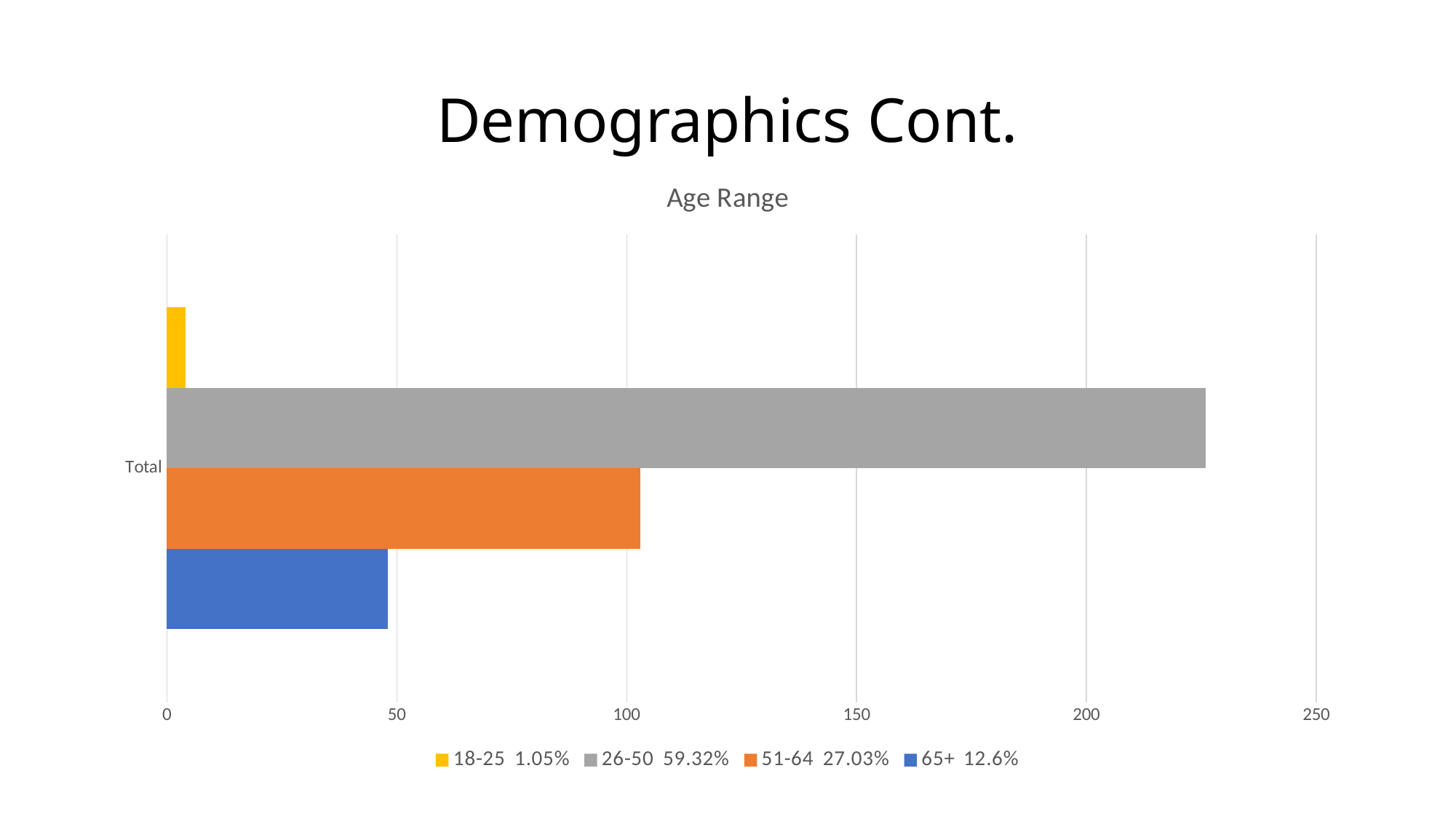
Is the value for 51-64 greater or less than 100? greater What is the title of the chart? Age Range How many series does the legend list? 4 How many categories are shown on the vertical axis? 1 What kind of chart is shown on the slide? bar chart Is the value for 18-25 greater or less than 50? less Which age range has the shortest bar? 18-25 Is the value for 65+ greater or less than 50? less What percentage does the legend show for the 26-50 age range? 59.32% Which age range has the longest bar? 26-50 Which is larger, the bar for 51-64 or the bar for 65+? 51-64